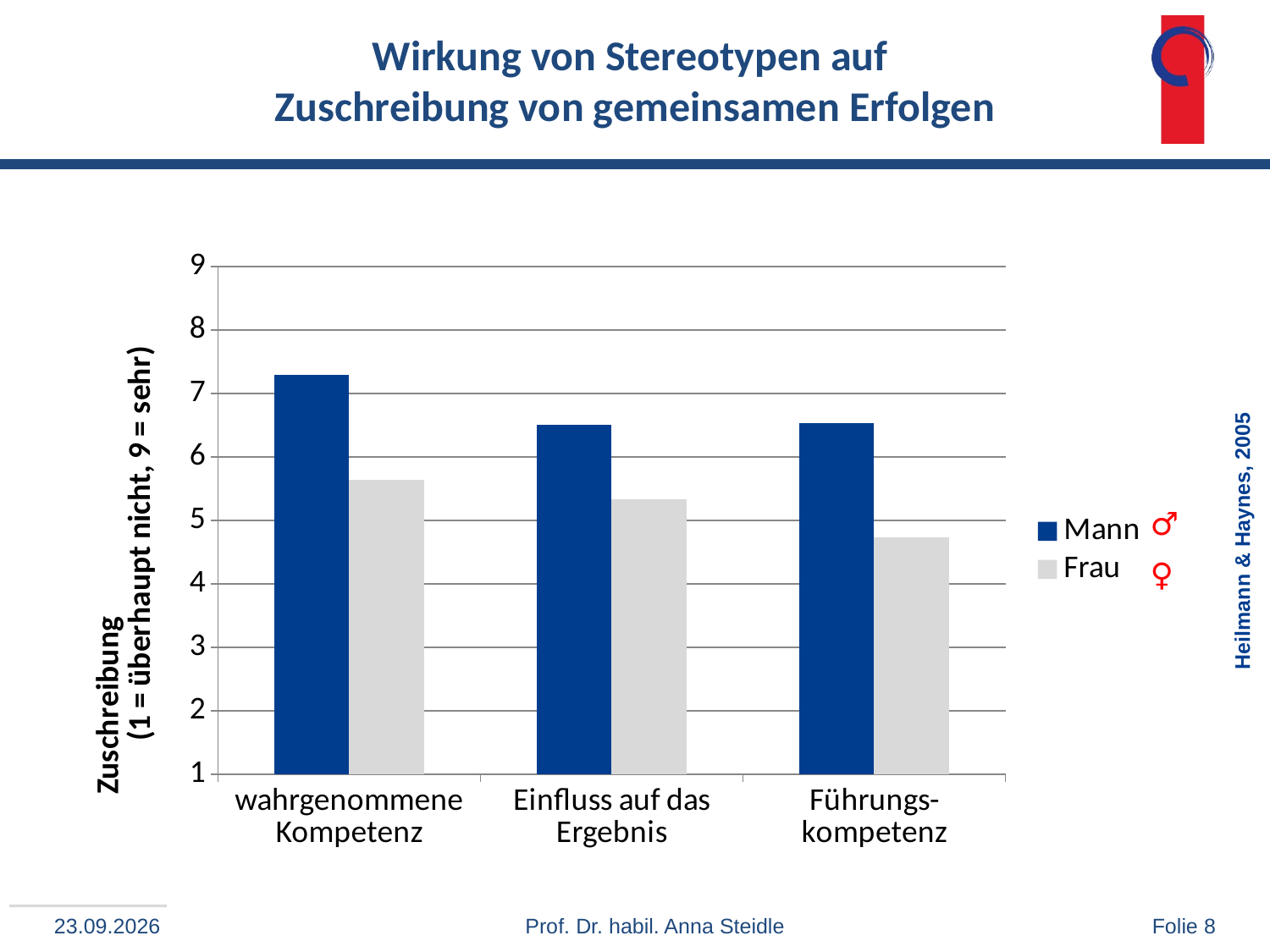
For the Frau series, which category has the highest value? wahrgenommene Kompetenz What are the two entries in the chart legend? Mann and Frau Which series has the higher value for wahrgenommene Kompetenz, Mann or Frau? Mann For the Mann series, which category has the highest value? wahrgenommene Kompetenz Is the value for Mann in wahrgenommene Kompetenz greater or less than 7? greater How many categories are shown on the x axis? 3 Is the value for Frau in Führungskompetenz greater or less than 5? less How many series does the legend list? 2 Which series has the higher value for Führungskompetenz, Mann or Frau? Mann What kind of chart is shown on the slide? bar chart Do the values for the Frau series rise or fall from left to right along the x axis? fall For the Frau series, which category has the lowest value? Führungskompetenz